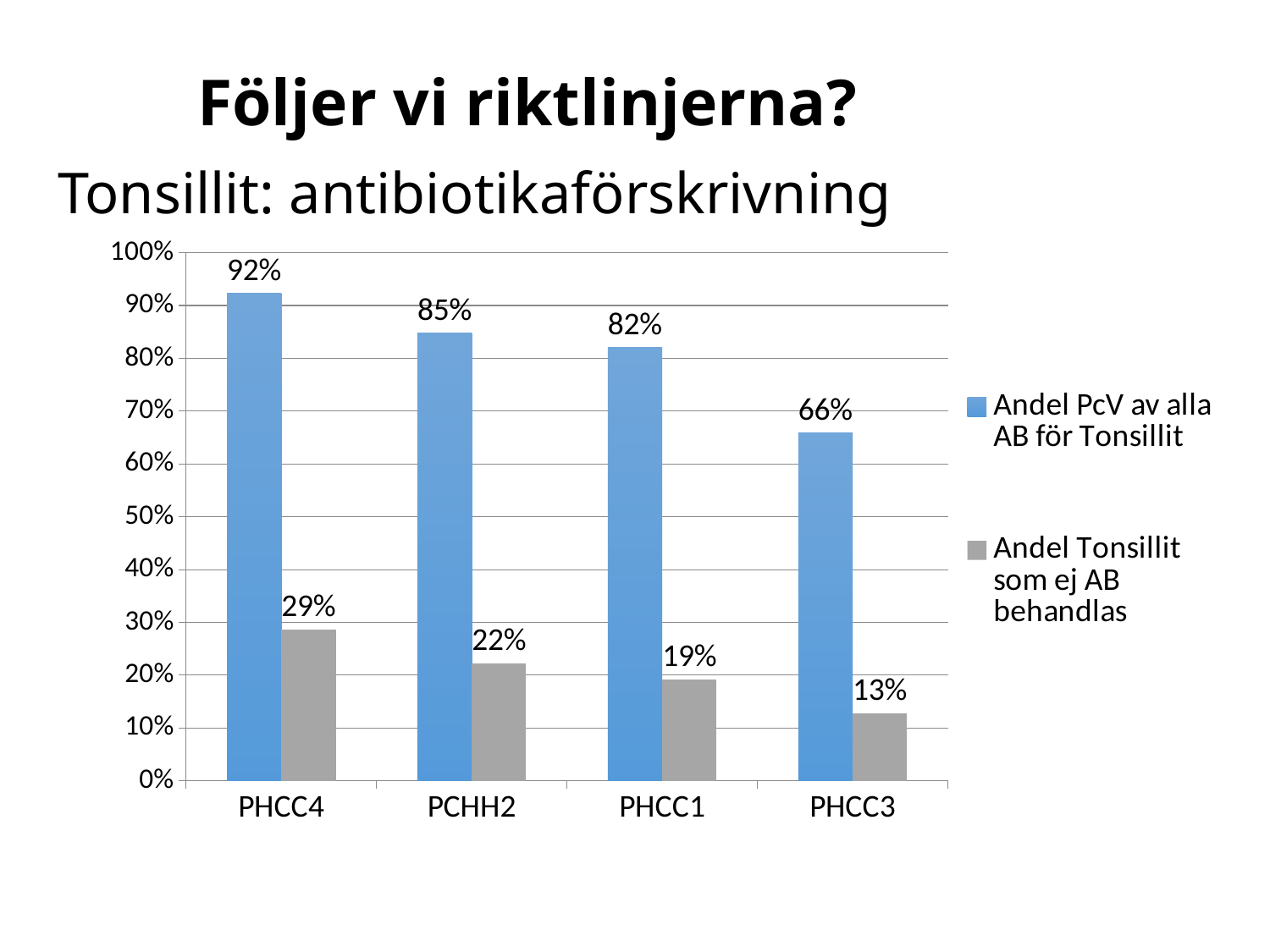
What is the difference between the "Andel PcV av alla AB för Tonsillit" values for PHCC4 and PHCC3? 26% What kind of chart is shown on the slide? Bar chart Is the value of "Andel PcV av alla AB för Tonsillit" for PCHH2 greater or less than 80%? greater What is the value of "Andel Tonsillit som ej AB behandlas" for PHCC3? 13% Do the values of "Andel Tonsillit som ej AB behandlas" rise or fall from left to right along the x axis? Fall How many series does the legend list? 2 What is the value of "Andel PcV av alla AB för Tonsillit" for PHCC4? 92% What is the value of "Andel PcV av alla AB för Tonsillit" for PHCC1? 82% Which is larger: "Andel Tonsillit som ej AB behandlas" for PCHH2 or for PHCC1? PCHH2 Which category has the highest value for "Andel Tonsillit som ej AB behandlas"? PHCC4 How many categories are shown on the x axis? 4 Which category has the lowest value for "Andel PcV av alla AB för Tonsillit"? PHCC3